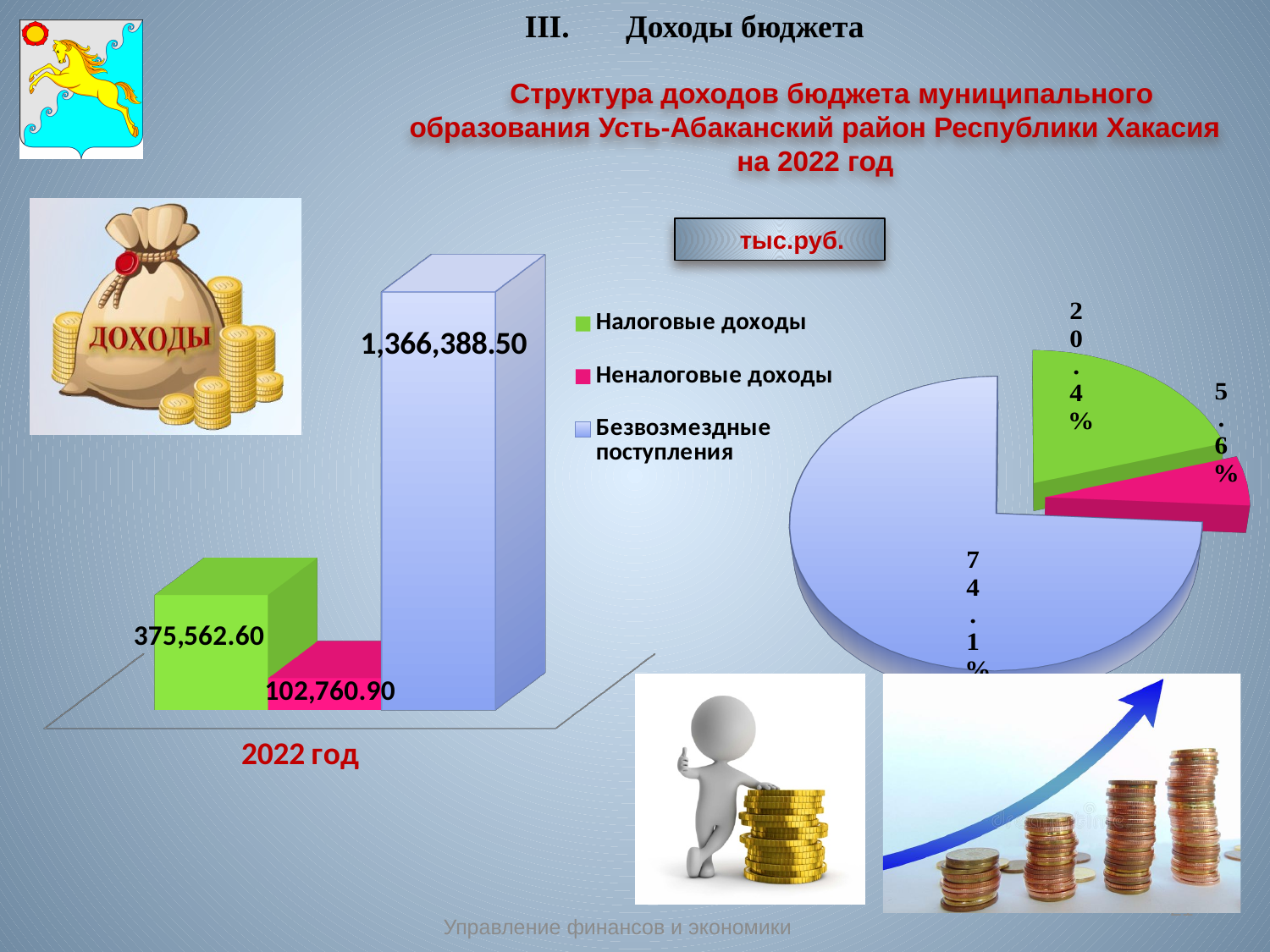
What unit is stated for the values on the slide? тыс.руб. On the bar chart on the left, what is the difference between Налоговые доходы and Неналоговые доходы? 272,801.70 On the bar chart on the left, what is the value for Неналоговые доходы? 102,760.90 What kind of chart is shown on the left of the slide? Bar chart On the pie chart on the right, what share does the largest (blue) slice have? 74.1% On the bar chart on the left, what is the value for Налоговые доходы? 375,562.60 On the bar chart on the left, which series has the lowest value? Неналоговые доходы On the pie chart on the right, what share does the green slice have? 20.4% How many series does the legend of the bar chart on the left list? 3 On the bar chart on the left, what is the value for Безвозмездные поступления? 1,366,388.50 On the bar chart on the left, which is larger: Налоговые доходы or Неналоговые доходы? Налоговые доходы On the bar chart on the left, which series has the highest value? Безвозмездные поступления